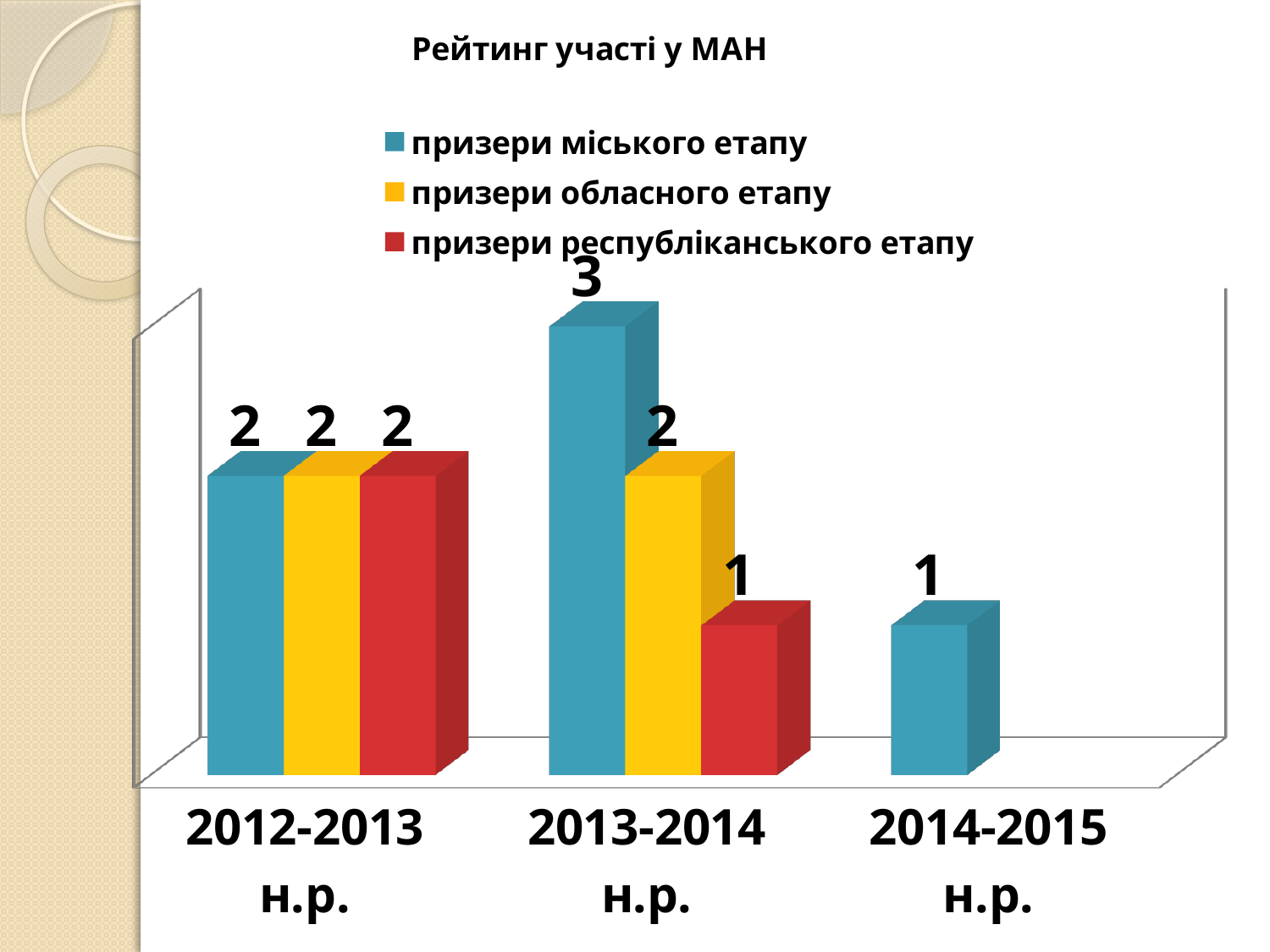
In which school year is the value for призери міського етапу highest? 2013-2014 н.р. How many school years are shown on the x axis? 3 What is the value for призери республіканського етапу in 2013-2014 н.р.? 1 In which school year is the value for призери міського етапу lowest? 2014-2015 н.р. What is the value for призери обласного етапу in 2012-2013 н.р.? 2 What is the value for призери міського етапу in 2014-2015 н.р.? 1 What is the title of the chart? Рейтинг участі у МАН What kind of chart is shown on the slide? bar chart What is the difference between призери міського етапу and призери республіканського етапу in 2013-2014 н.р.? 2 How many series does the legend list? 3 What is the value for призери міського етапу in 2013-2014 н.р.? 3 Which is larger in 2013-2014 н.р.: призери обласного етапу or призери республіканського етапу? призери обласного етапу